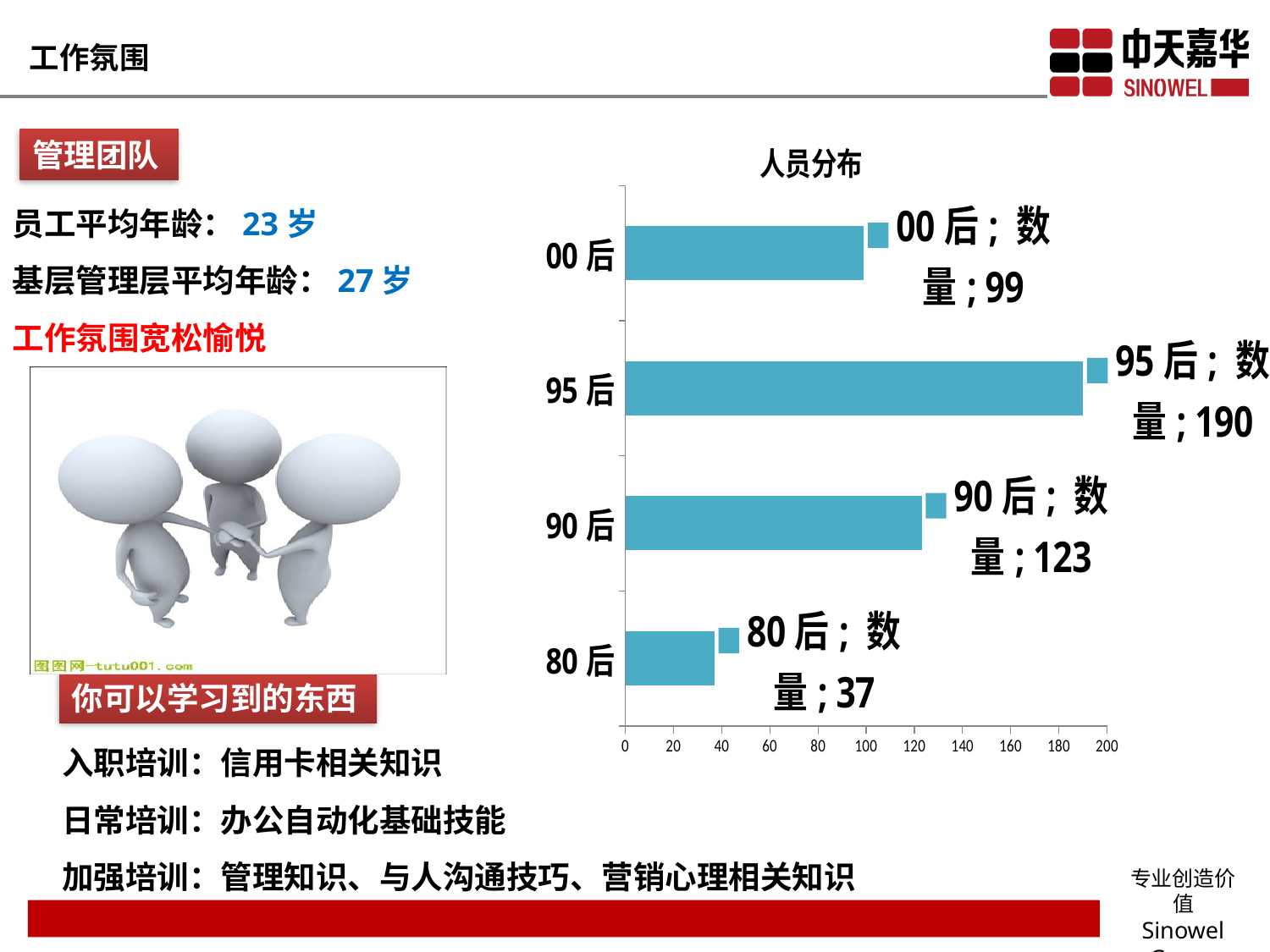
What is the value for 90后 in the 人员分布 chart? 123 Which is larger in the 人员分布 chart, the value for 00后 or the value for 90后? 90后 Is the value for 95后 in the 人员分布 chart greater or less than 180? greater What is the value for 95后 in the 人员分布 chart? 190 Which category has the lowest value in the 人员分布 chart? 80后 What is the title of the chart on the slide? 人员分布 What is the value for 00后 in the 人员分布 chart? 99 Which category has the highest value in the 人员分布 chart? 95后 What is the difference between the values for 95后 and 90后 in the 人员分布 chart? 67 What is the value for 80后 in the 人员分布 chart? 37 How many categories are shown in the 人员分布 chart? 4 What kind of chart is the 人员分布 chart? bar chart